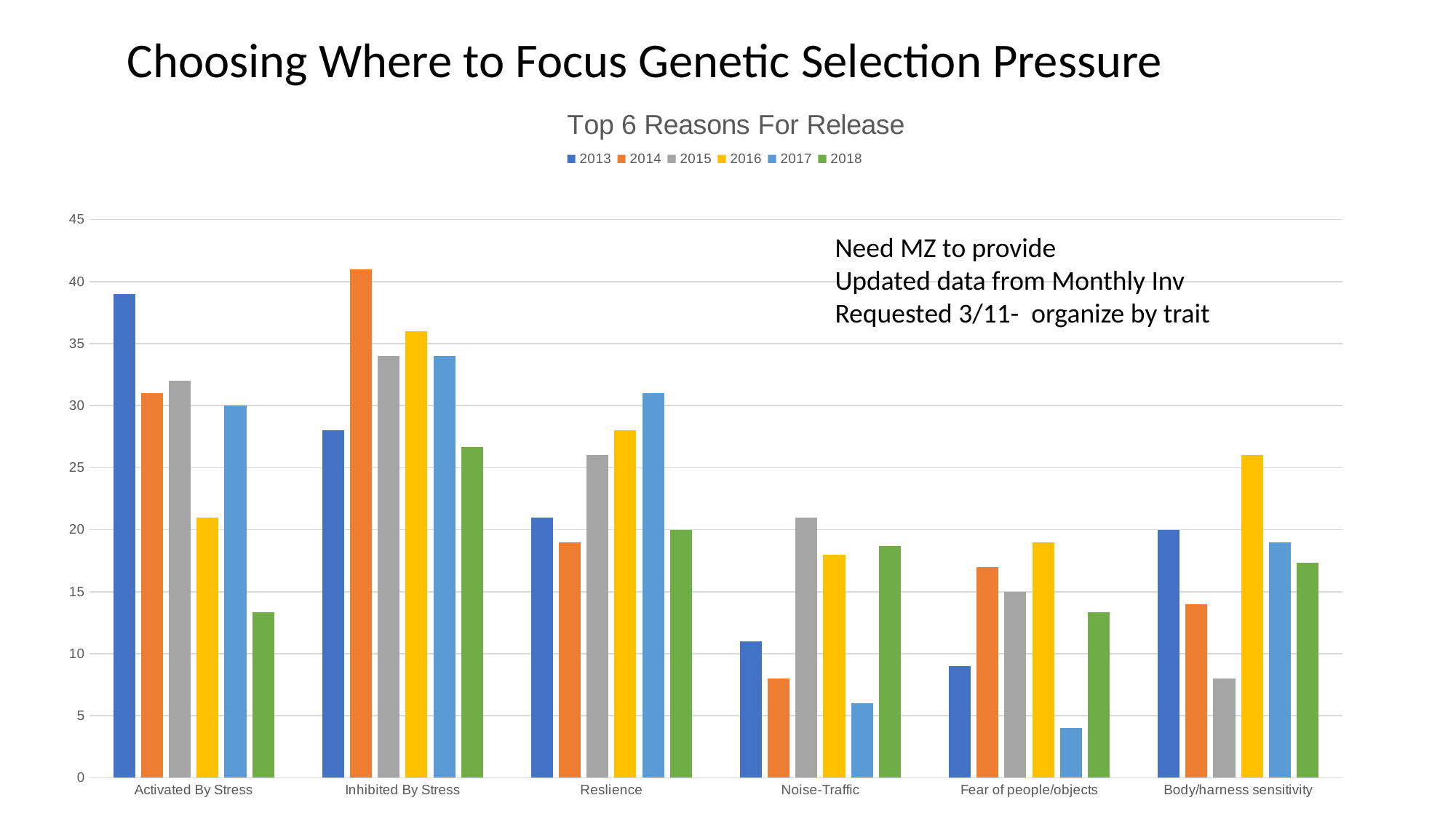
What kind of chart is shown on the slide? bar chart Which category and year has the tallest bar in the chart? Inhibited By Stress, 2014 Which year has the highest bar for Activated By Stress? 2013 How many series does the legend list? 6 What is the title of the chart? Top 6 Reasons For Release Is the 2014 value for Inhibited By Stress greater or less than 40? greater How many categories are shown on the x axis? 6 Is the 2016 value for Body/harness sensitivity greater or less than 25? greater For Reslience, which year has the larger value, 2017 or 2014? 2017 Is the 2014 value for Noise-Traffic greater or less than 10? less Which year has the lowest bar for Fear of people/objects? 2017 For Noise-Traffic, which year has the larger value, 2015 or 2017? 2015